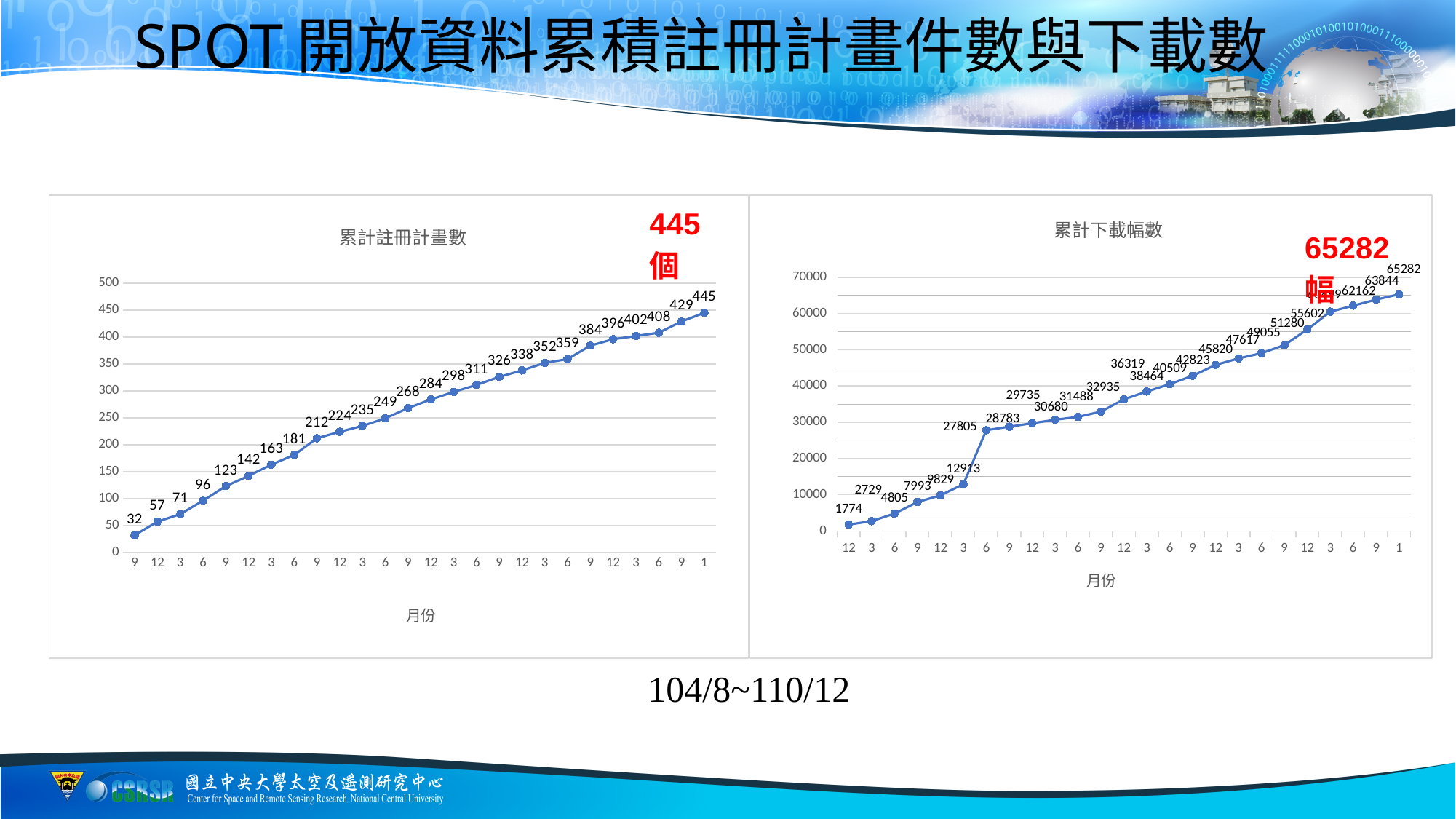
In the left chart (累計註冊計畫數), do the values rise or fall along the x axis? rise In the left chart (累計註冊計畫數), what is the value of the last data point? 445 In the right chart (累計下載幅數), what is the highest value plotted? 65282 How many data points are plotted in the left chart (累計註冊計畫數)? 26 In the right chart (累計下載幅數), is the value of the last data point greater or less than 60000? greater In the left chart (累計註冊計畫數), what is the difference between the last two data points (429 and 445)? 16 What is the x-axis title of the right chart (累計下載幅數)? 月份 In the right chart (累計下載幅數), what is the difference between the last two data points (63844 and 65282)? 1438 In the left chart (累計註冊計畫數), what is the value of the first data point? 32 How many data points are plotted in the right chart (累計下載幅數)? 25 In the right chart (累計下載幅數), what is the value of the first data point? 1774 What type of chart is the left chart titled 累計註冊計畫數? line chart